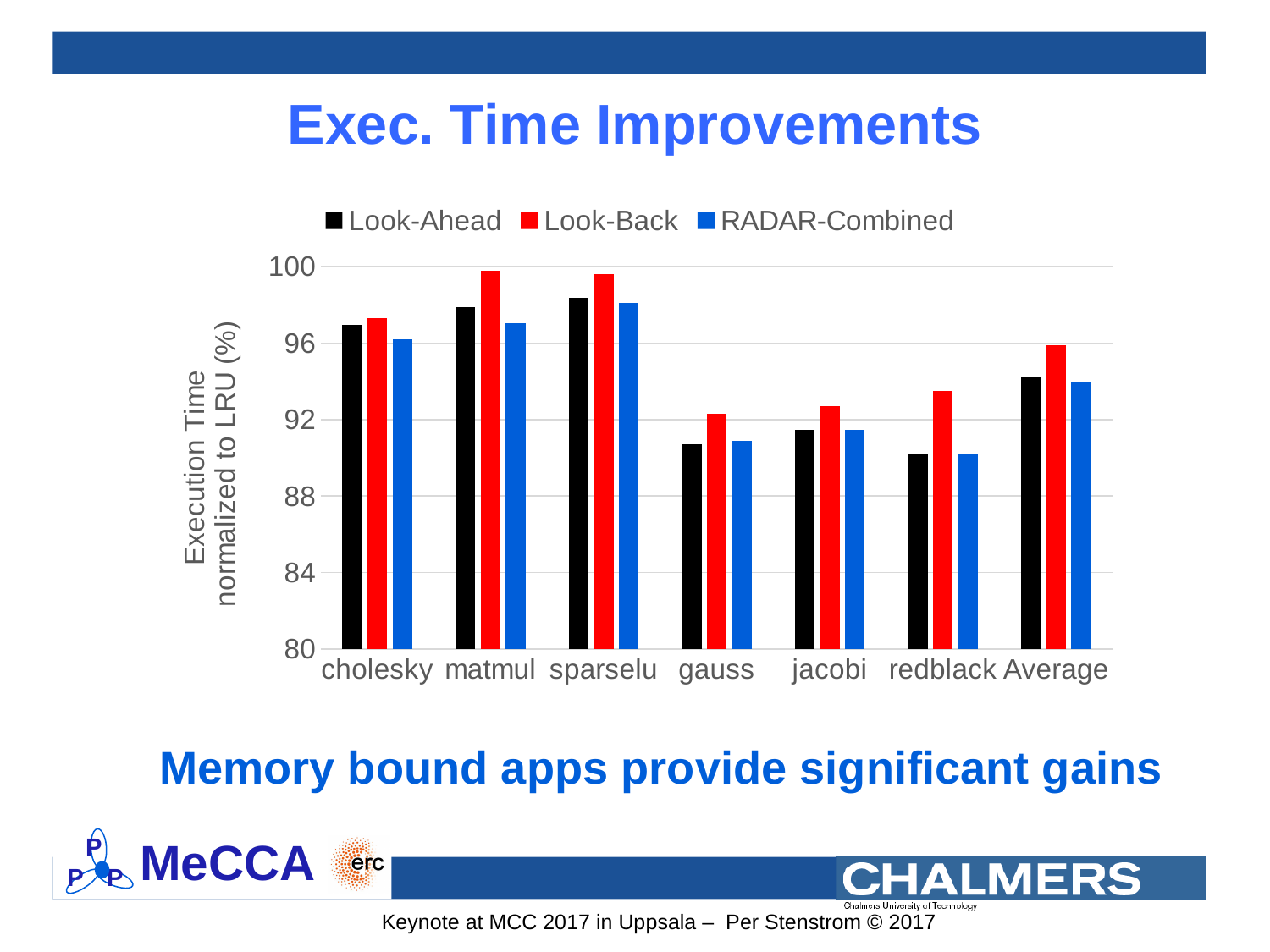
How many series does the legend list? 3 Is the RADAR-Combined value for redblack greater or less than 88? greater Is the Look-Back value for matmul greater or less than 96? greater Is the Look-Ahead value for Average greater or less than 92? greater For redblack, which is larger: the Look-Ahead value or the Look-Back value? Look-Back What kind of chart is shown on the slide? bar chart For cholesky, which is larger: the Look-Ahead value or the RADAR-Combined value? Look-Ahead How many categories are shown on the x axis? 7 Which category has the highest RADAR-Combined value? sparselu Which series is shown in red in the legend? Look-Back What is the label of the y axis? Execution Time normalized to LRU (%)